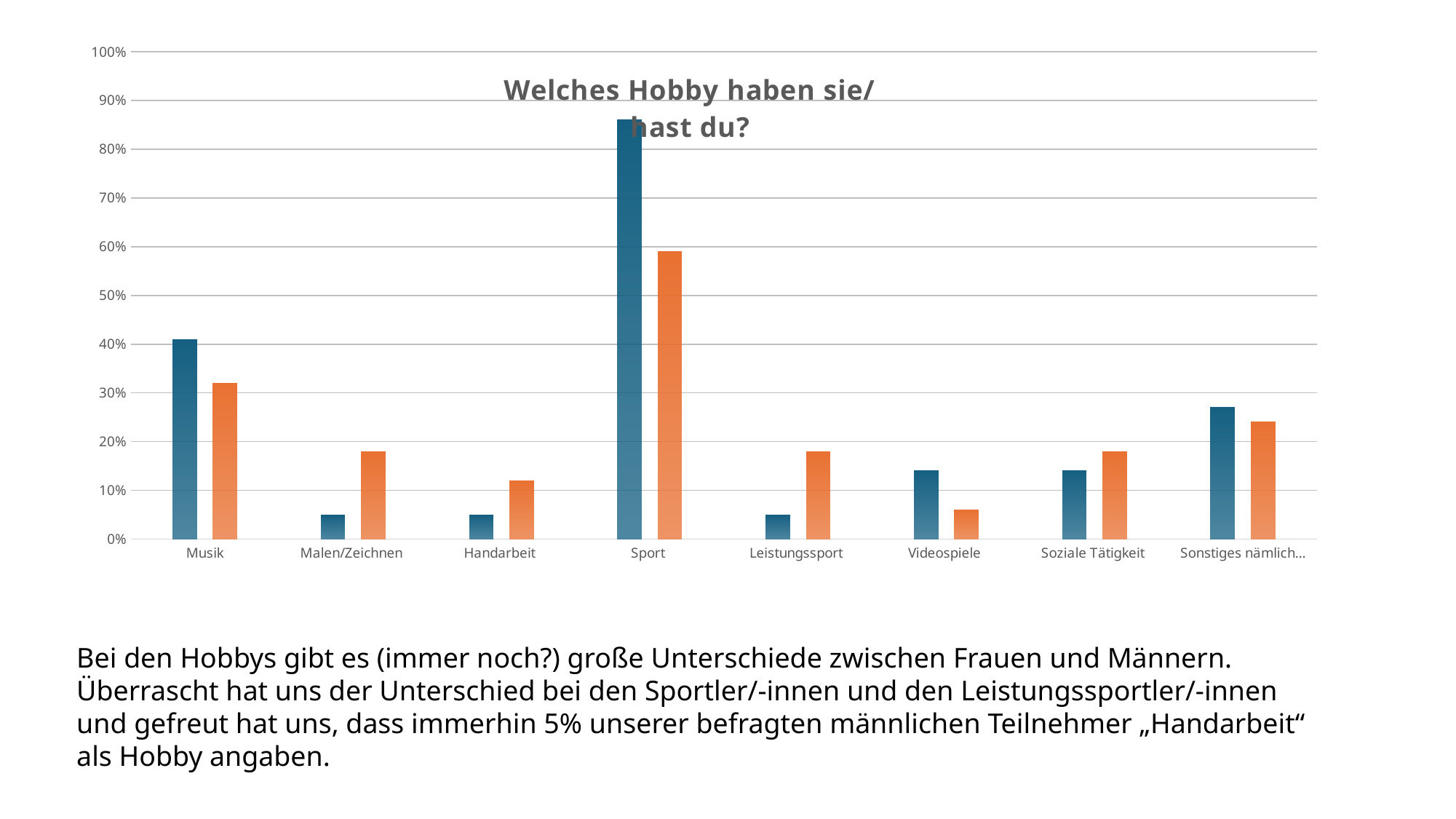
For Malen/Zeichnen, which bar is larger, the blue one or the orange one? orange Which category has the highest blue bar? Sport Is the blue bar for Musik greater or less than 30%? greater What is the title of the chart? Welches Hobby haben sie/ hast du? How many hobby categories are shown on the x axis? 8 Is the orange bar for Handarbeit greater or less than 20%? less For Musik, which bar is larger, the blue one or the orange one? blue Which category has the highest orange bar? Sport Is the orange bar for Sport greater or less than 50%? greater What kind of chart is shown on the slide? bar chart Which category has the lowest orange bar? Videospiele